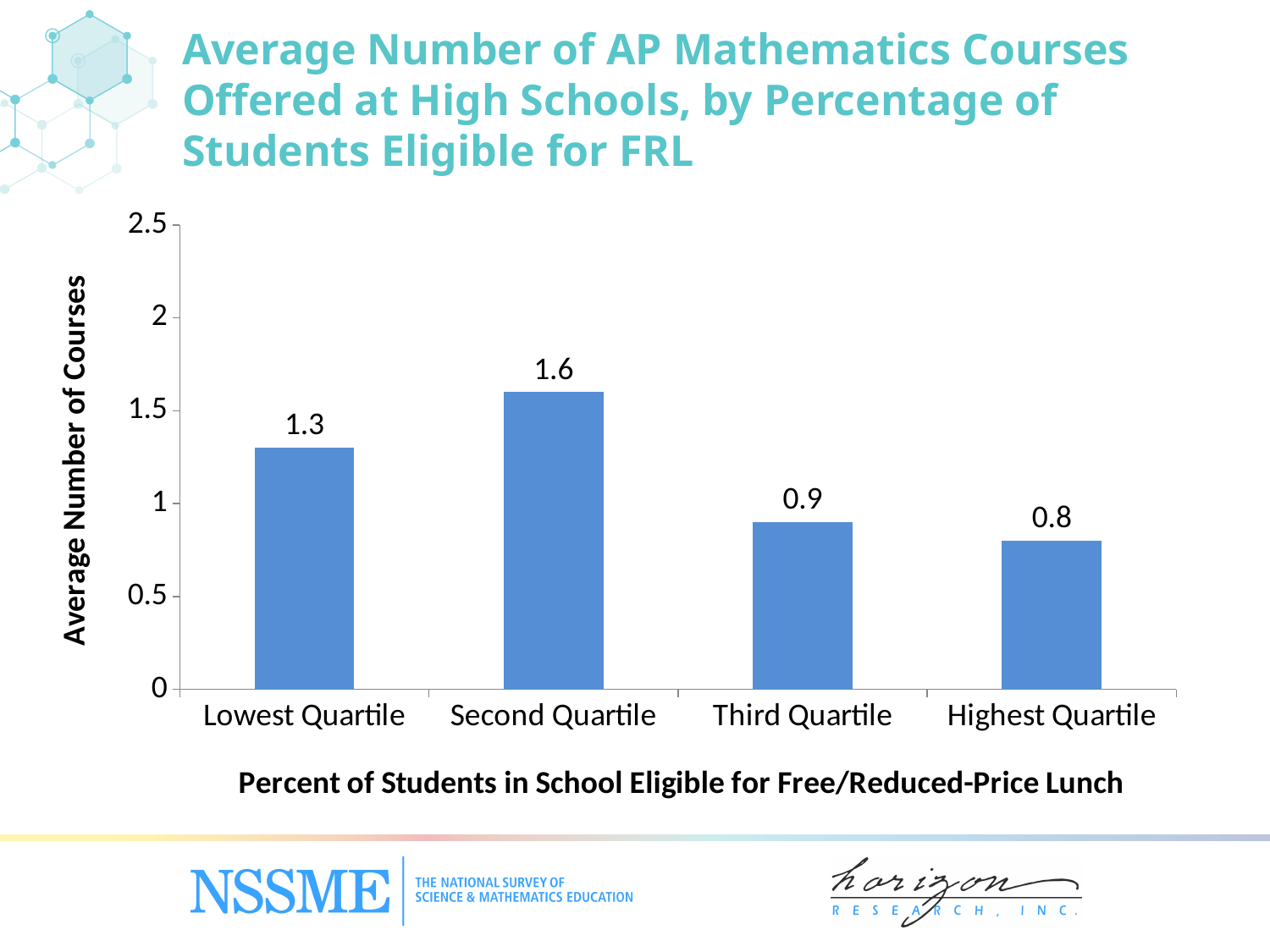
What is the average number of AP mathematics courses offered at schools in the Lowest Quartile? 1.3 What is the average number of AP mathematics courses offered at schools in the Third Quartile? 0.9 Which quartile has the lowest average number of AP mathematics courses? Highest Quartile What is the label of the vertical axis? Average Number of Courses Is the value for the Second Quartile greater or less than 1.5? greater Which quartile has the highest average number of AP mathematics courses? Second Quartile What is the average number of AP mathematics courses offered at schools in the Second Quartile? 1.6 What kind of chart is shown on the slide? Bar chart What is the average number of AP mathematics courses offered at schools in the Highest Quartile? 0.8 How many quartile categories are shown on the x axis? 4 What is the difference between the average number of courses in the Second Quartile and the Highest Quartile? 0.8 Which has a higher average number of AP mathematics courses, the Lowest Quartile or the Third Quartile? Lowest Quartile